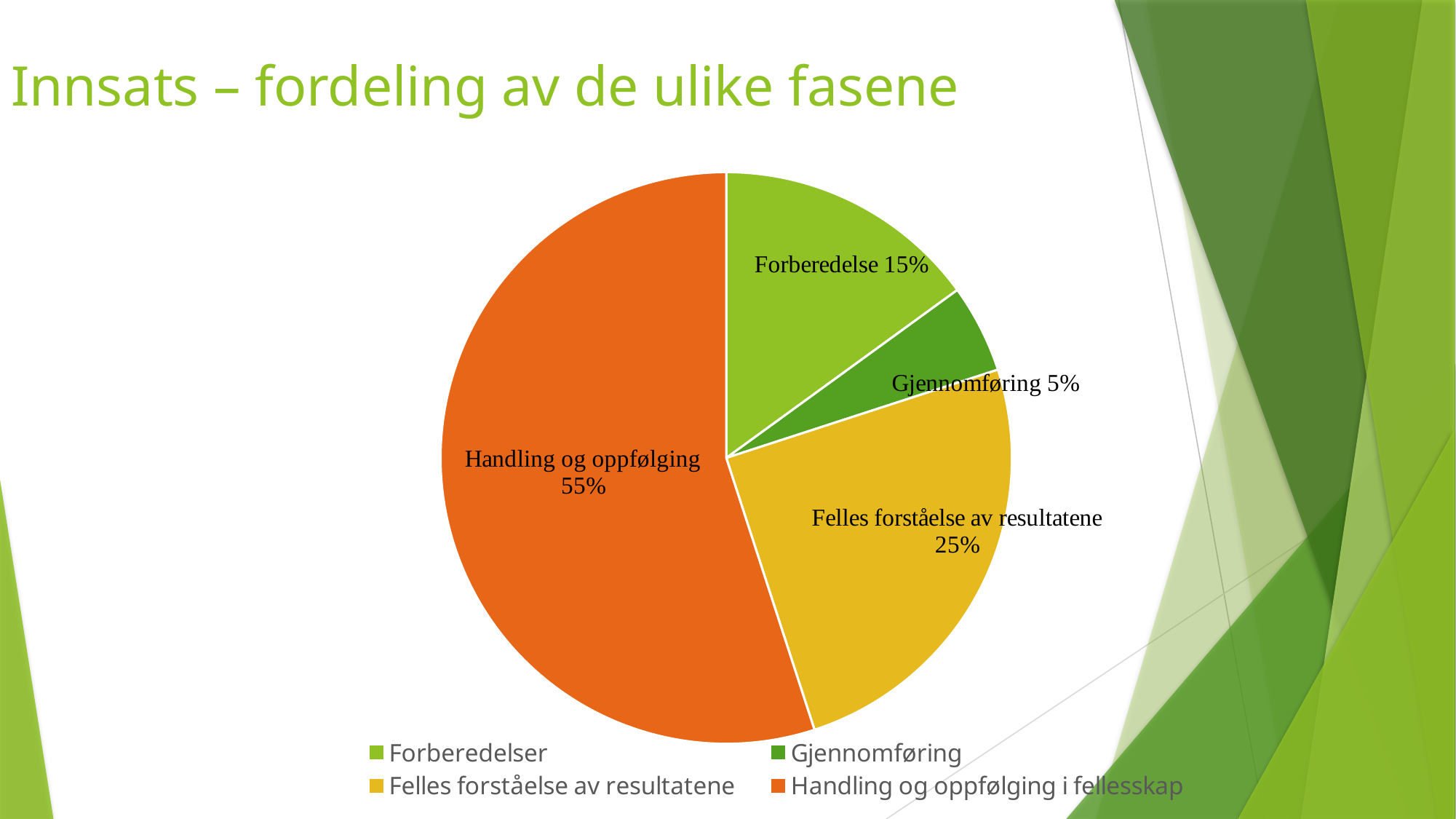
What share of the pie does Forberedelse have? 15% Which slice of the pie is the smallest? Gjennomføring What kind of chart is shown on the slide? Pie chart What is the difference in percentage points between Handling og oppfølging and Felles forståelse av resultatene? 30 Which is larger, Forberedelse or Felles forståelse av resultatene? Felles forståelse av resultatene Which slice of the pie is the largest? Handling og oppfølging What colour is the Handling og oppfølging i fellesskap slice? Orange What is the difference in percentage points between Forberedelse and Gjennomføring? 10 What share of the pie does Gjennomføring have? 5% What share of the pie does Felles forståelse av resultatene have? 25% How many slices does the pie chart have? 4